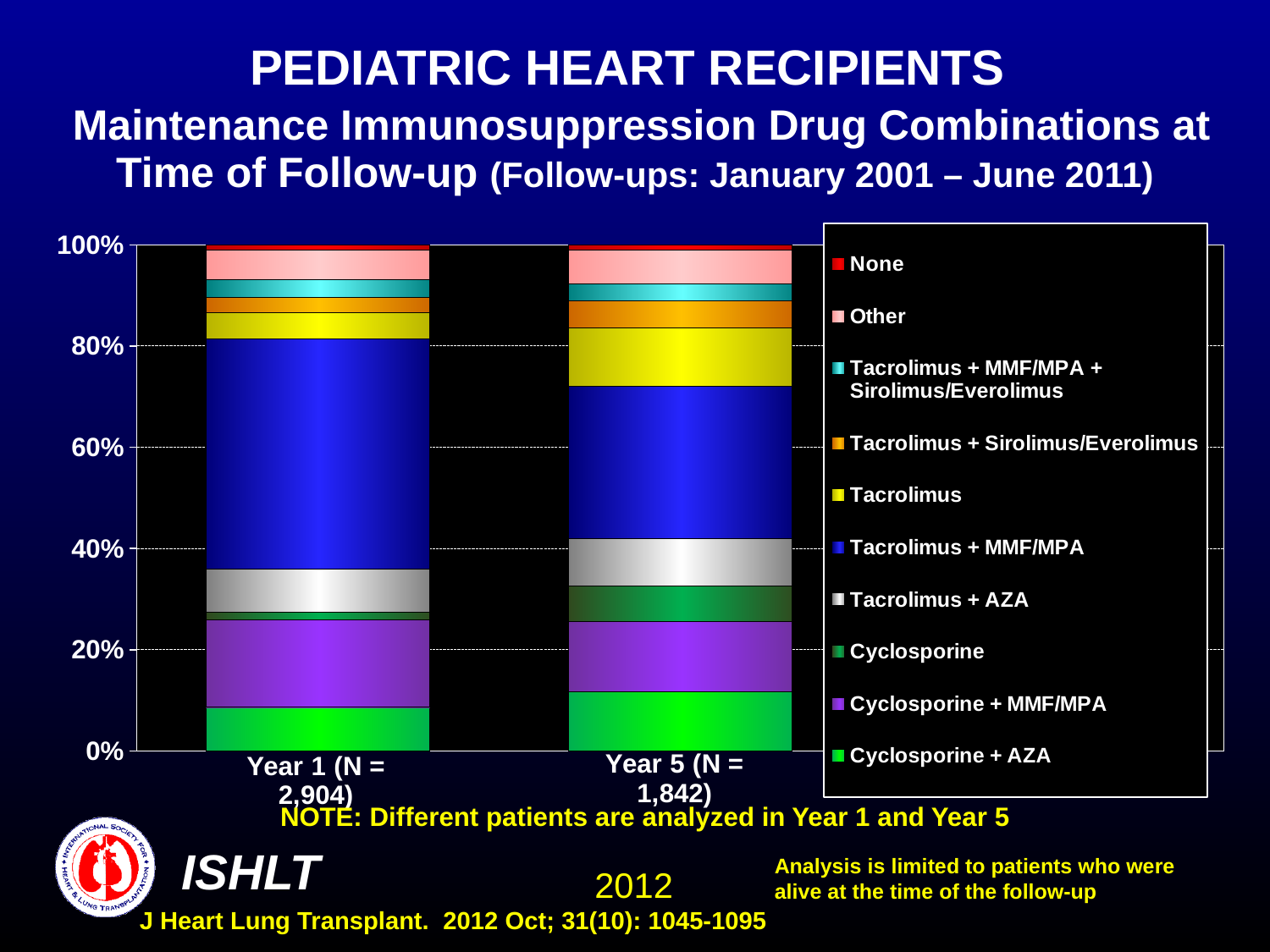
What is the total of the Year 1 stacked bar? 100% Is the Tacrolimus + MMF/MPA share larger in Year 1 or Year 5? Year 1 Which legend entry is shown in yellow? Tacrolimus Is the Tacrolimus + MMF/MPA share in Year 1 greater or less than 40%? greater Is the Tacrolimus (alone) share larger in Year 1 or Year 5? Year 5 How many series does the legend list? 10 What is the N shown for the Year 5 bar? 1,842 What kind of chart is shown on the slide? Stacked bar chart Is the Cyclosporine (alone) share larger in Year 1 or Year 5? Year 5 Which drug combination makes up the largest segment of the Year 5 bar? Tacrolimus + MMF/MPA How many bars (categories) are plotted on the x axis? 2 Which drug combination makes up the largest segment of the Year 1 bar? Tacrolimus + MMF/MPA